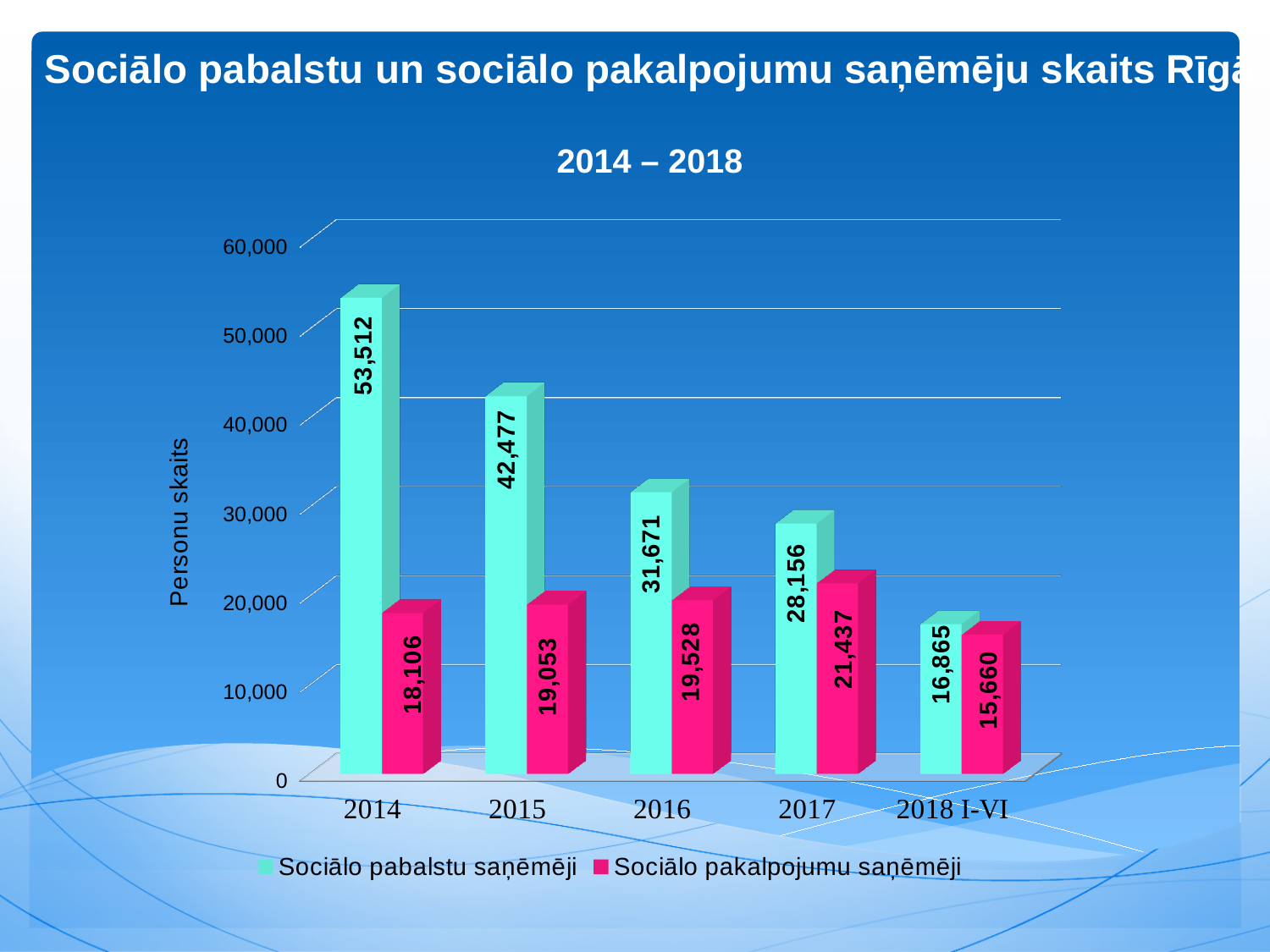
What is the value for Sociālo pabalstu saņēmēji in 2014? 53,512 Which year has the highest value for Sociālo pabalstu saņēmēji? 2014 What is the value for Sociālo pabalstu saņēmēji in 2018 I-VI? 16,865 How many series does the legend list? 2 Which category has the lowest value for Sociālo pakalpojumu saņēmēji? 2018 I-VI What is the difference between Sociālo pabalstu saņēmēji and Sociālo pakalpojumu saņēmēji in 2016? 12,143 How many categories are shown on the x axis? 5 Which is larger in 2015: Sociālo pabalstu saņēmēji or Sociālo pakalpojumu saņēmēji? Sociālo pabalstu saņēmēji What kind of chart is shown on the slide? bar chart Is the value for Sociālo pabalstu saņēmēji in 2017 greater or less than 30,000? less Do the values for Sociālo pabalstu saņēmēji rise or fall from 2014 to 2018 I-VI? fall What is the value for Sociālo pakalpojumu saņēmēji in 2017? 21,437